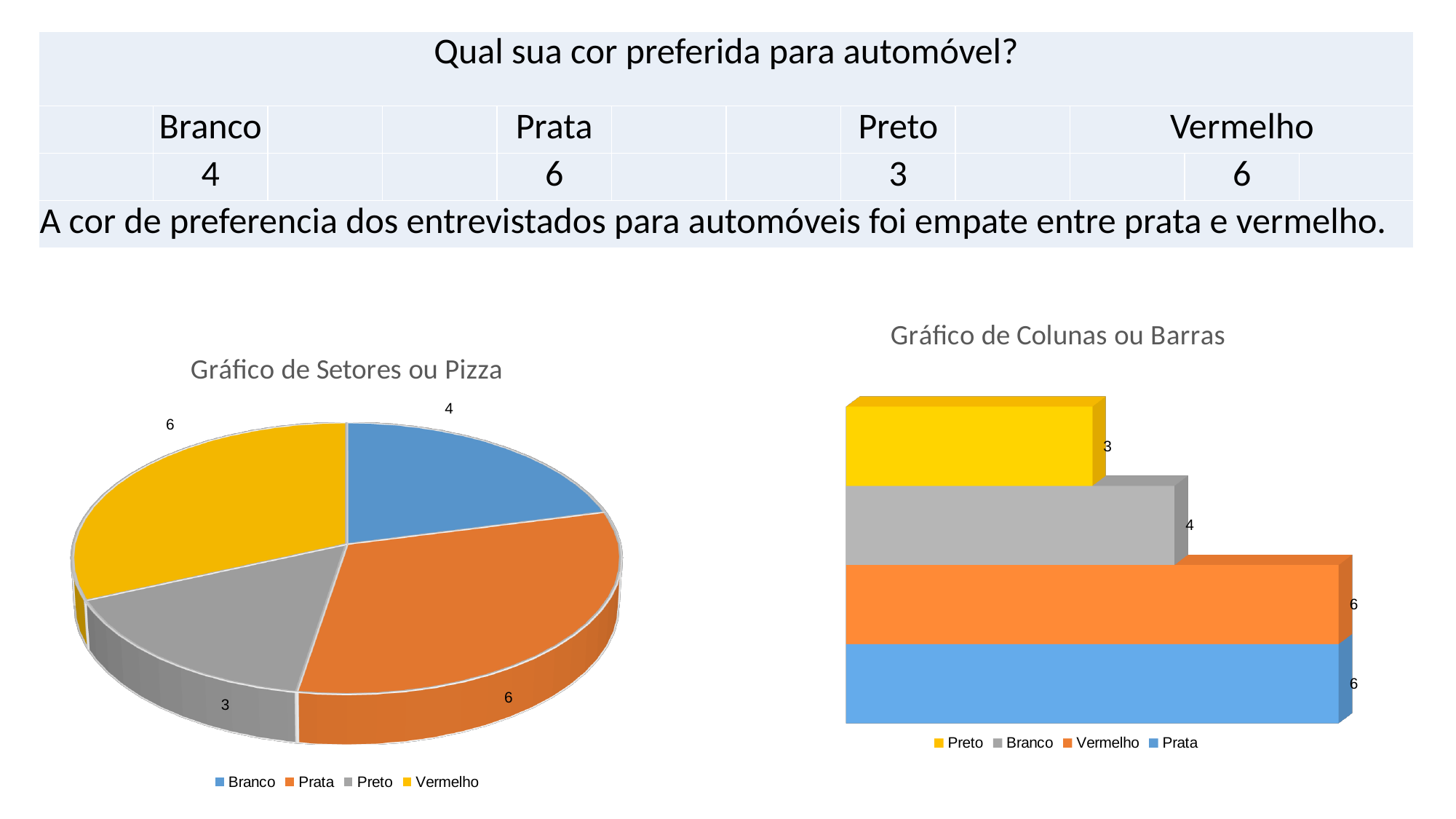
In the chart titled "Gráfico de Colunas ou Barras", what is the value for Vermelho? 6 What kind of chart is the chart titled "Gráfico de Setores ou Pizza"? Pie chart In the chart titled "Gráfico de Setores ou Pizza", what is the value for Branco? 4 In the chart titled "Gráfico de Colunas ou Barras", which is larger, the value for Branco or the value for Preto? Branco In the chart titled "Gráfico de Colunas ou Barras", which category has the lowest value? Preto In the chart titled "Gráfico de Setores ou Pizza", what is the difference between the values for Prata and Preto? 3 In the chart titled "Gráfico de Colunas ou Barras", what colour is the bar for Preto? Yellow How many categories are shown in the chart titled "Gráfico de Setores ou Pizza"? 4 How many bars are shown in the chart titled "Gráfico de Colunas ou Barras"? 4 In the chart titled "Gráfico de Setores ou Pizza", what is the value for Preto? 3 What kind of chart is the chart titled "Gráfico de Colunas ou Barras"? Bar chart In the chart titled "Gráfico de Setores ou Pizza", what share of the total does the Preto slice represent? 3 out of 19